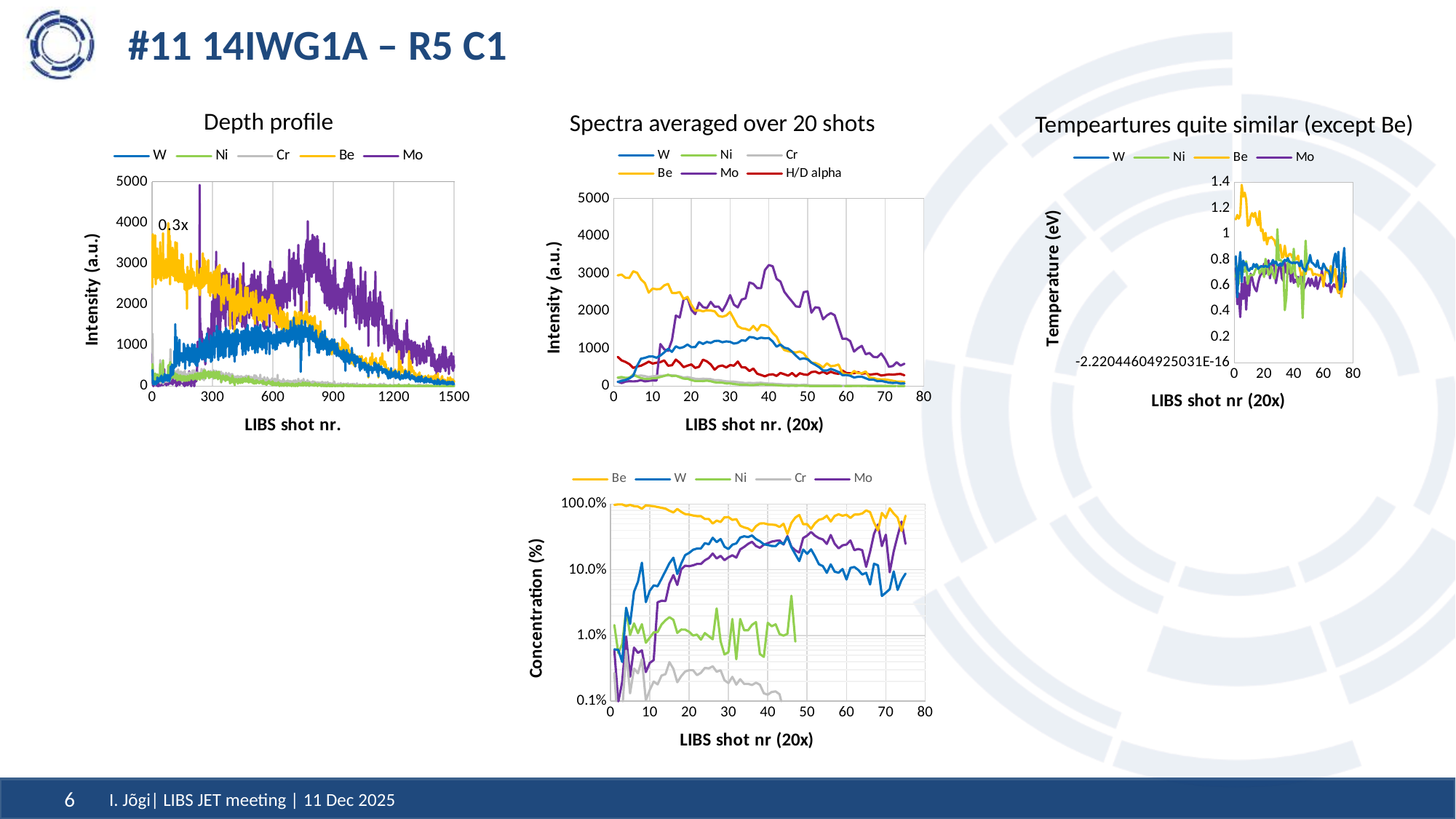
How many series does the legend of the "Spectra averaged over 20 shots" chart list? 6 In the "Spectra averaged over 20 shots" chart, is the Be value at LIBS shot nr. 0 greater or less than 2000? greater In the bottom-middle concentration chart, which series has the lowest concentration values? Cr What kind of chart is the "Depth profile" chart? line chart In the "Tempeartures quite similar (except Be)" chart, is the Be temperature at LIBS shot nr 0 greater or less than 1 eV? greater In the "Spectra averaged over 20 shots" chart, which series has the larger value at LIBS shot nr. 40, Mo or W? Mo How many series does the legend of the "Depth profile" chart list? 5 How many series does the legend of the bottom-middle concentration chart list? 5 In the bottom-middle concentration chart, is the Be value at LIBS shot nr 0 greater or less than 10.0%? greater In the "Depth profile" chart, what is the label of the x axis? LIBS shot nr. In the "Spectra averaged over 20 shots" chart, does the Be series rise or fall along the x axis? fall In the "Depth profile" chart, what is the maximum value shown on the y axis? 5000